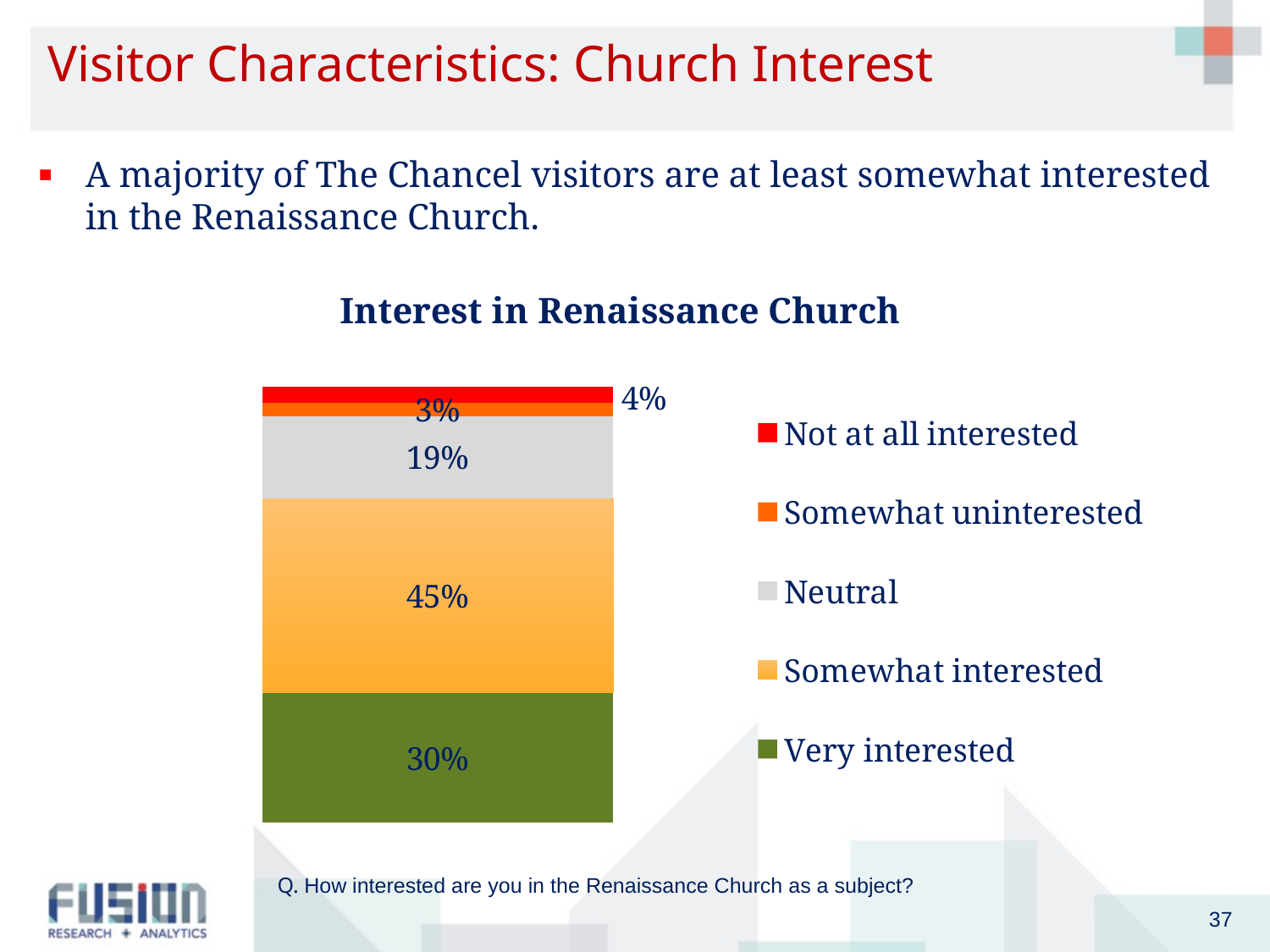
What is the difference between the 'Somewhat interested' and 'Very interested' percentages? 15% What percentage of visitors are 'Neutral' about the Renaissance Church? 19% Which colour represents 'Very interested' in the chart? Green What is the title of the chart on the slide? Interest in Renaissance Church What is the difference between the 'Somewhat interested' and 'Neutral' percentages? 26% Which is larger: the share of 'Neutral' visitors or the share of 'Very interested' visitors? Very interested What percentage of visitors are 'Very interested' in the Renaissance Church? 30% How many response categories does the legend of the 'Interest in Renaissance Church' chart list? 5 What is the combined percentage of visitors who are 'Very interested' or 'Somewhat interested'? 75% What percentage of visitors are 'Somewhat interested' in the Renaissance Church? 45% Which response category has the largest share in the 'Interest in Renaissance Church' chart? Somewhat interested What type of chart is shown under the title 'Interest in Renaissance Church'? Stacked bar chart